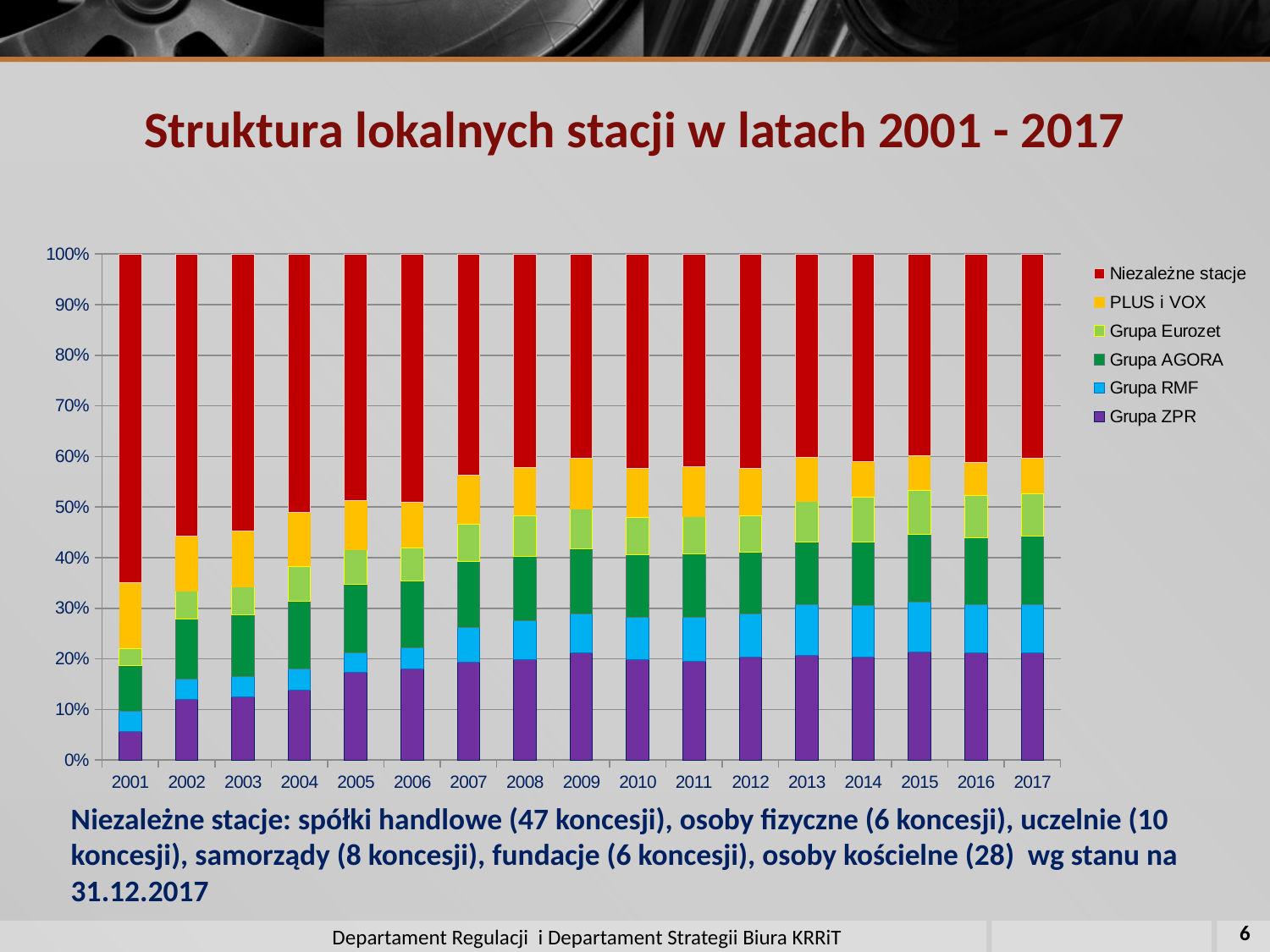
Which colour represents Niezależne stacje in the chart? red What is the total height of each stacked bar in the chart? 100% How many years (categories) are shown on the x axis of the chart? 17 Is the share of Niezależne stacje in 2017 greater or less than 50%? less What kind of chart is shown on the slide? stacked bar chart Is the share of Grupa ZPR in 2001 greater or less than 10%? less Does the share of Grupa ZPR rise or fall from 2001 to 2017? rise Is the share of Niezależne stacje in 2001 greater or less than 60%? greater What is the title of the chart on the slide? Struktura lokalnych stacji w latach 2001 - 2017 How many series does the chart legend list? 6 Which year has the largest share of Niezależne stacje? 2001